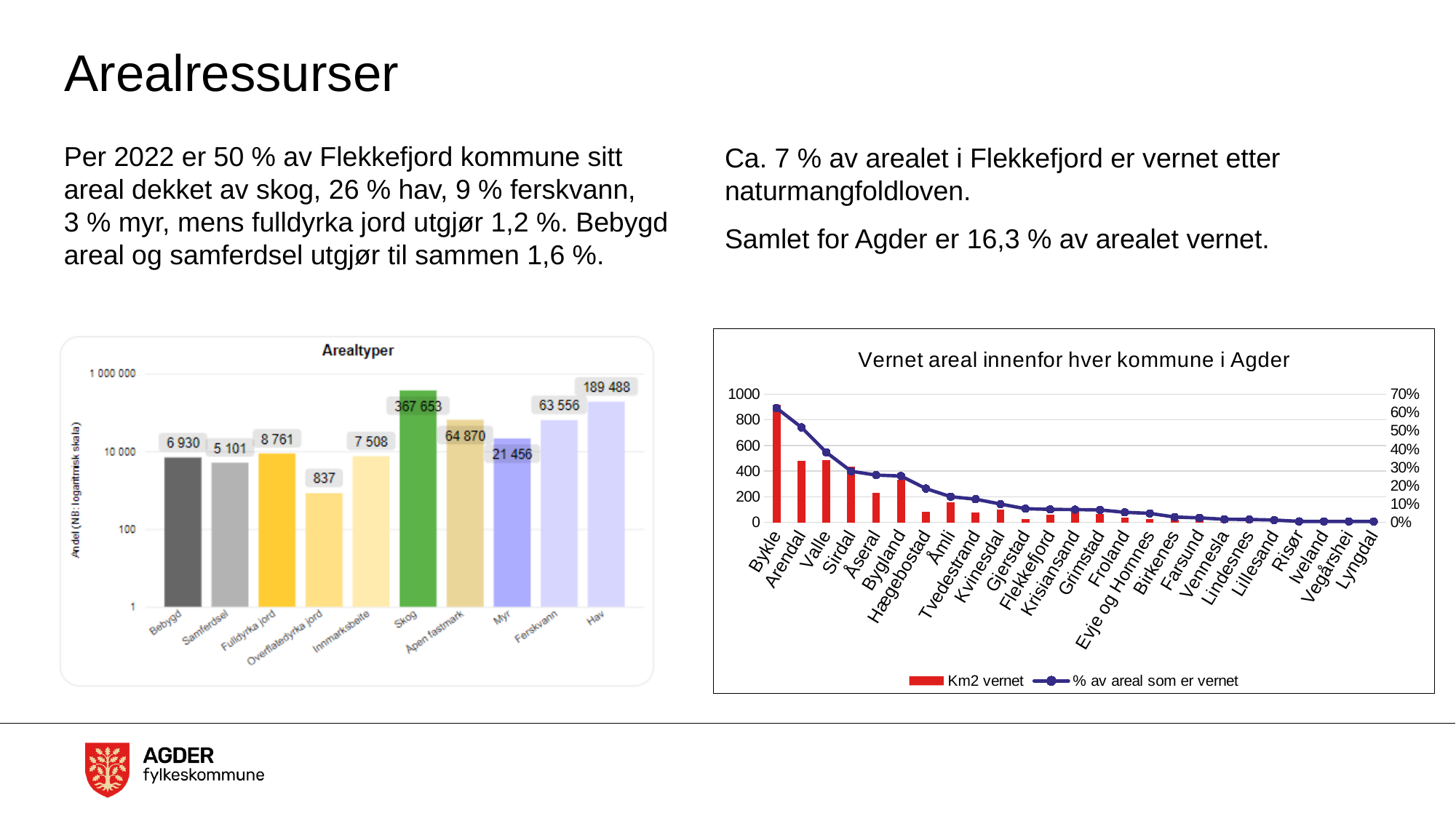
How many series does the legend list in the chart 'Vernet areal innenfor hver kommune i Agder'? 2 In the Arealtyper chart, which category has the lowest value? Overflatedyrka jord In the chart 'Vernet areal innenfor hver kommune i Agder', does the '% av areal som er vernet' line rise or fall from Bykle to Lyngdal? fall In the Arealtyper chart, which is larger, Bebygd or Samferdsel? Bebygd In the chart 'Vernet areal innenfor hver kommune i Agder', which municipality has the highest Km2 vernet? Bykle How many categories are shown in the Arealtyper chart? 10 In the Arealtyper chart, what is the value for Hav? 189 488 In the Arealtyper chart, what is the value for Skog? 367 653 In the Arealtyper chart, what is the difference between the values for Åpen fastmark and Ferskvann? 1 314 In the Arealtyper chart, what is the value for Overflatedyrka jord? 837 In the chart 'Vernet areal innenfor hver kommune i Agder', is the Km2 vernet value for Bykle greater or less than 800? greater In the Arealtyper chart, which category has the highest value? Skog